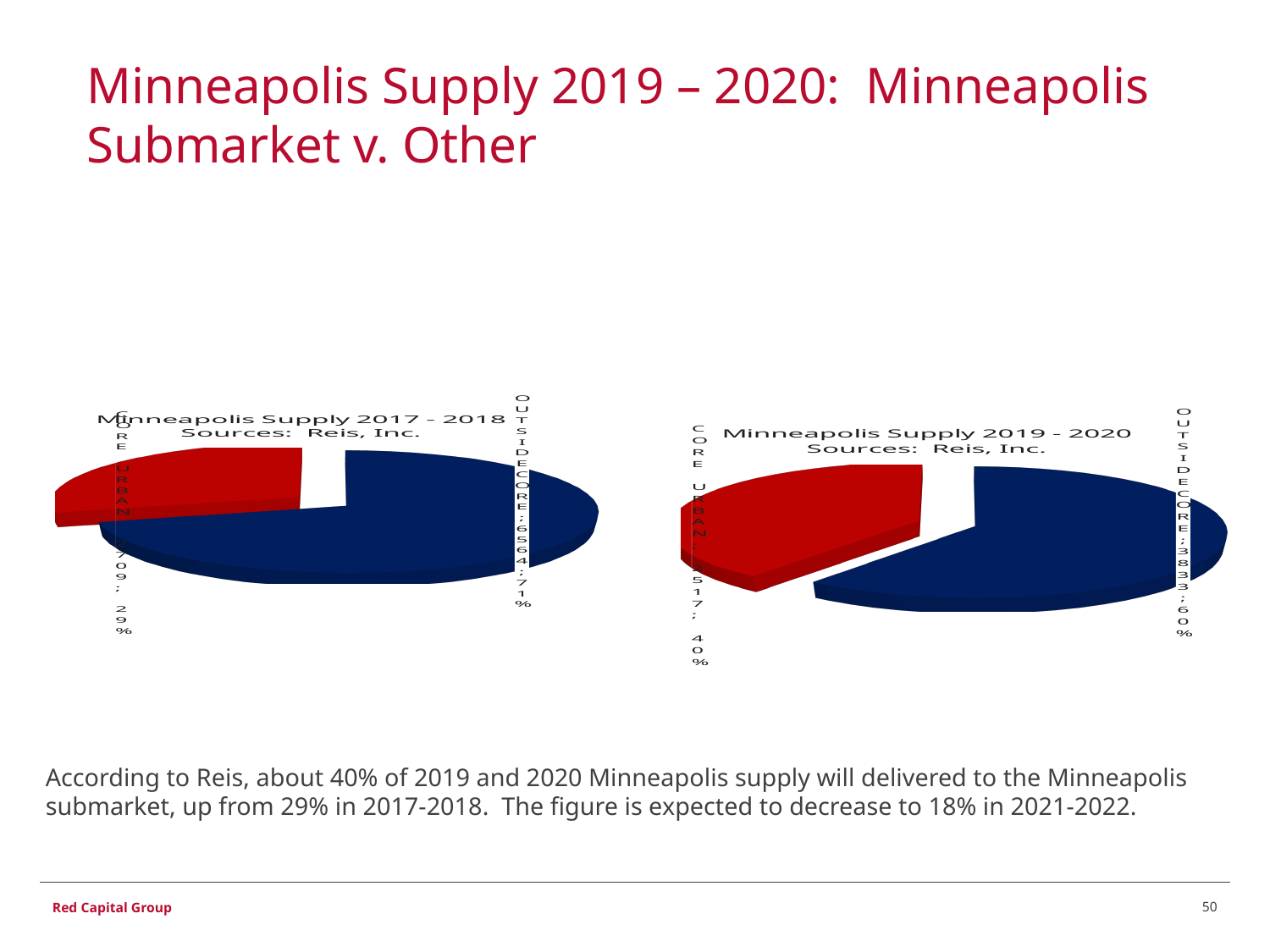
In the Minneapolis Supply 2019 - 2020 chart, what share of the pie is OUTSIDE CORE? 60% In the Minneapolis Supply 2017 - 2018 chart, what is the value for OUTSIDE CORE? 6564 In the Minneapolis Supply 2017 - 2018 chart, what share of the pie is CORE URBAN? 29% In the Minneapolis Supply 2019 - 2020 chart, which slice is larger, CORE URBAN or OUTSIDE CORE? OUTSIDE CORE What colour is the CORE URBAN slice in the Minneapolis Supply 2017 - 2018 chart? Red How many slices does the Minneapolis Supply 2019 - 2020 pie chart have? 2 In the Minneapolis Supply 2017 - 2018 chart, which slice is the smallest? CORE URBAN In the Minneapolis Supply 2019 - 2020 chart, what is the difference in percentage points between the OUTSIDE CORE and CORE URBAN shares? 20 percentage points In the Minneapolis Supply 2019 - 2020 chart, what share of the pie is CORE URBAN? 40% What kind of chart is the Minneapolis Supply 2017 - 2018 chart on the left? Pie chart In the Minneapolis Supply 2019 - 2020 chart, what is the value for OUTSIDE CORE? 3833